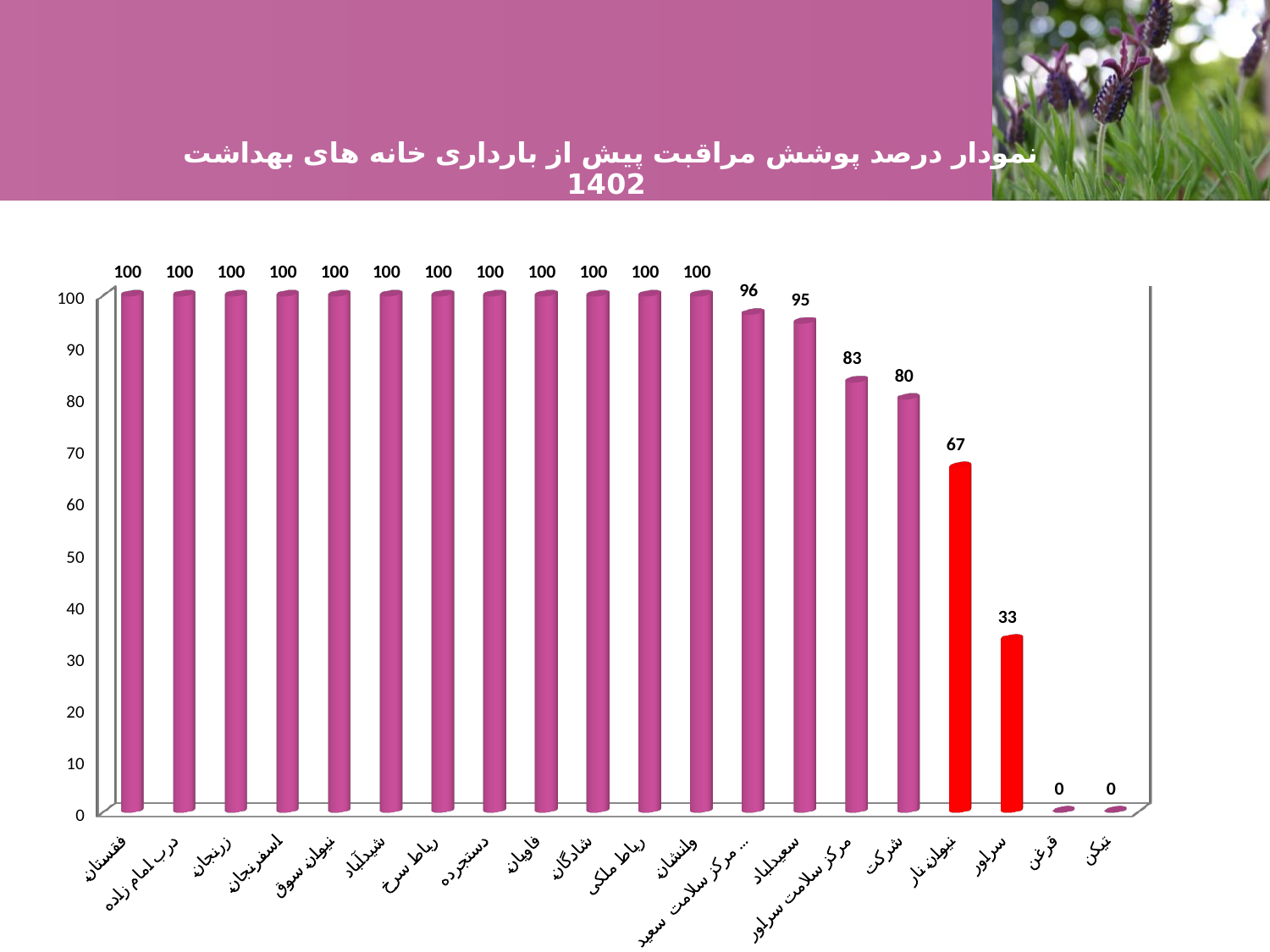
What is the difference between the values for سعیدآباد and شرکت? 15 How many categories are shown on the x axis? 20 Which category has the lowest value among those with a non-zero bar? سراور How many bars are coloured red? 2 Which is larger, the value for نیوان نار or the value for سراور? نیوان نار What is the value for نیوان نار? 67 What kind of chart is shown on the slide? bar chart What is the value for سعیدآباد? 95 Do the values rise or fall moving from left to right along the x axis? fall What is the value for شرکت? 80 What is the value for مرکز سلامت سراور? 83 What is the value for سراور? 33